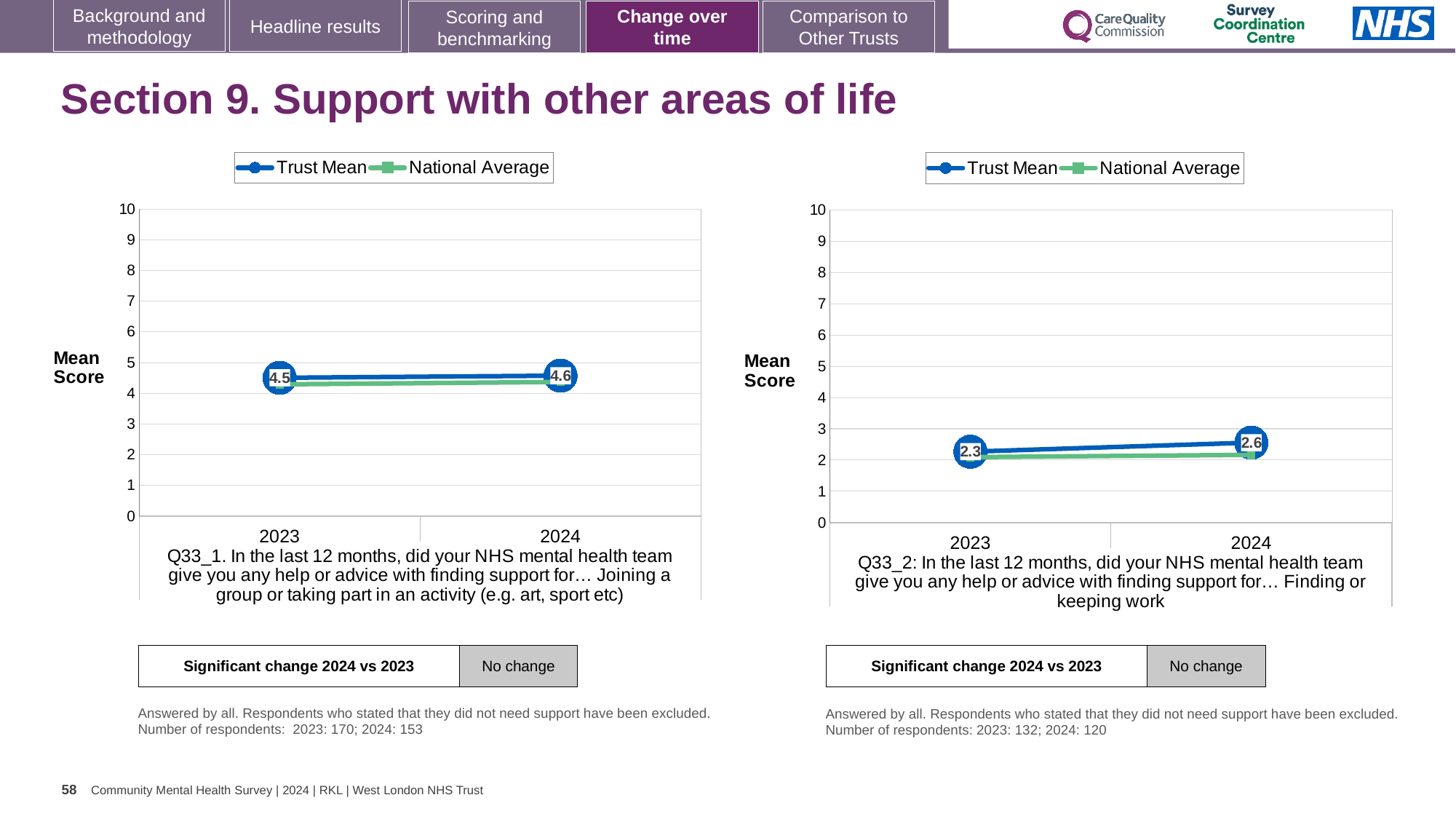
In the right chart (Q33_2), what is the Trust Mean for 2023? 2.3 In the right chart (Q33_2), which is larger in 2024, the Trust Mean or the National Average? Trust Mean In the left chart (Q33_1), by how much did the Trust Mean change from 2023 to 2024? 0.1 In the right chart (Q33_2), does the Trust Mean rise or fall from 2023 to 2024? rise In the left chart (Q33_1), what is the Trust Mean for 2024? 4.6 How many series does the legend of the left chart list? 2 In the right chart (Q33_2), is the National Average for 2024 greater or less than 3? less In the right chart (Q33_2), by how much did the Trust Mean change from 2023 to 2024? 0.3 How many years are plotted on the x axis of the right chart? 2 What kind of chart is the left chart (Q33_1)? line chart In the left chart (Q33_1), what is the Trust Mean for 2023? 4.5 In the right chart (Q33_2), what is the Trust Mean for 2024? 2.6